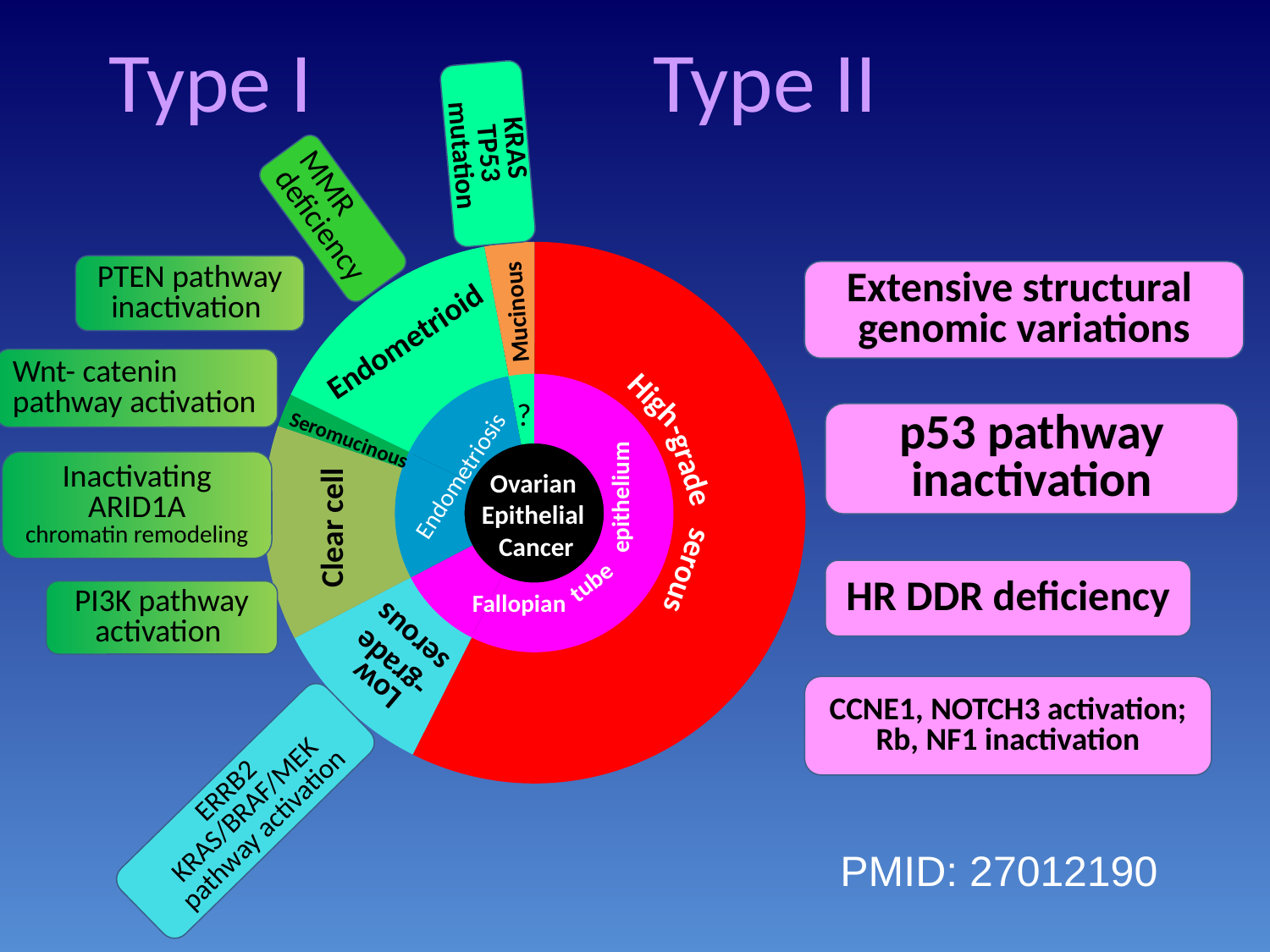
What kind of chart is shown in the centre of the slide? doughnut chart Which subtype occupies the smallest segment of the outer ring? Seromucinous Which outer-ring segment is larger, High-grade serous or Endometrioid? High-grade serous Which subtype occupies the largest segment of the outer ring? High-grade serous How many labelled segments are in the inner ring of the chart (including the one marked '?')? 3 Which outer-ring segment is larger, Endometrioid or Mucinous? Endometrioid What label is written in the black centre circle of the chart? Ovarian Epithelial Cancer Which outer-ring segment is larger, Clear cell or Low-grade serous? Clear cell What colour is the High-grade serous segment of the outer ring? red How many ovarian cancer subtypes are labelled in the outer ring of the chart? 6